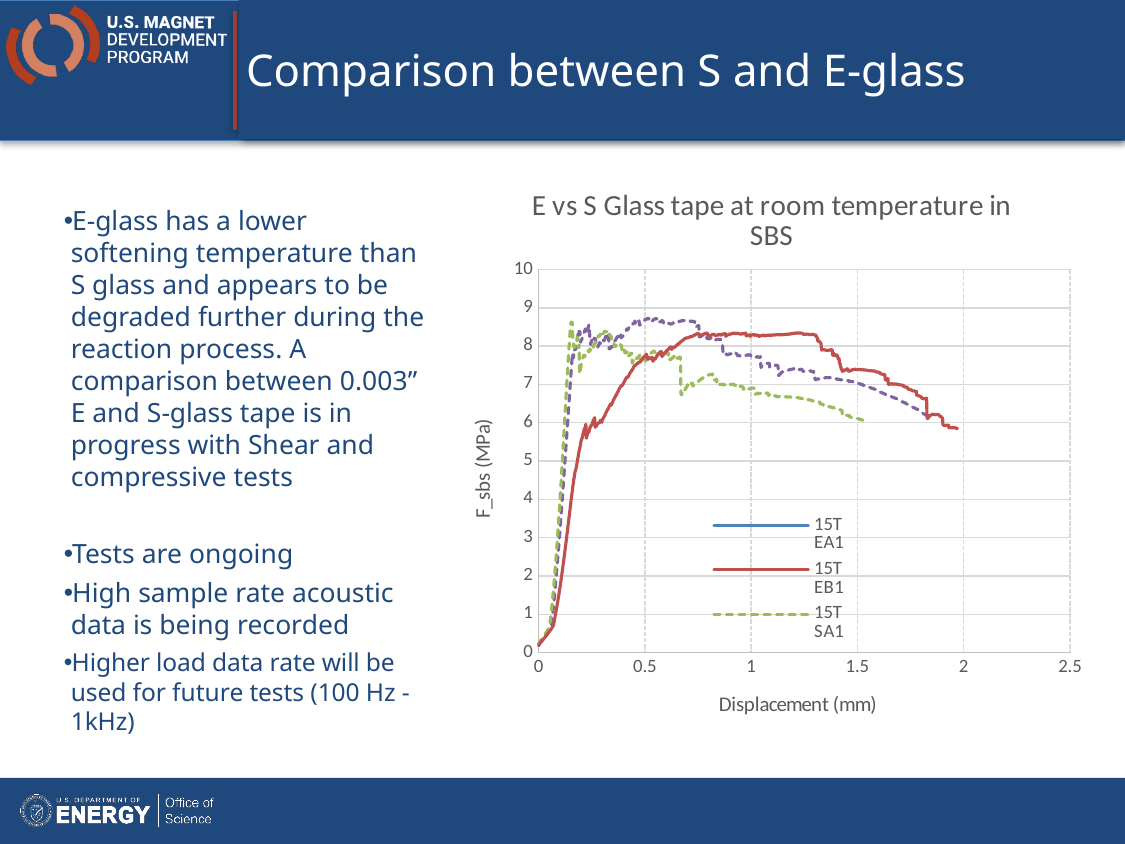
What kind of chart is shown on the slide? line chart What is the label of the chart's x axis? Displacement (mm) Is the peak value of the purple dashed line greater or less than 8 MPa? greater Which series ends at the smallest displacement on the x axis? 15T SA1 What is the highest value shown on the y axis of the chart? 10 Is the value of the solid red line at 0.5 mm displacement greater or less than 7 MPa? greater Do the curves rise or fall between 0 and 0.5 mm displacement? rise How many series does the chart legend list? 3 What is the label of the chart's y axis? F_sbs (MPa) Is the final value of the green dashed line (15T SA1) at about 1.5 mm displacement greater or less than 7 MPa? less